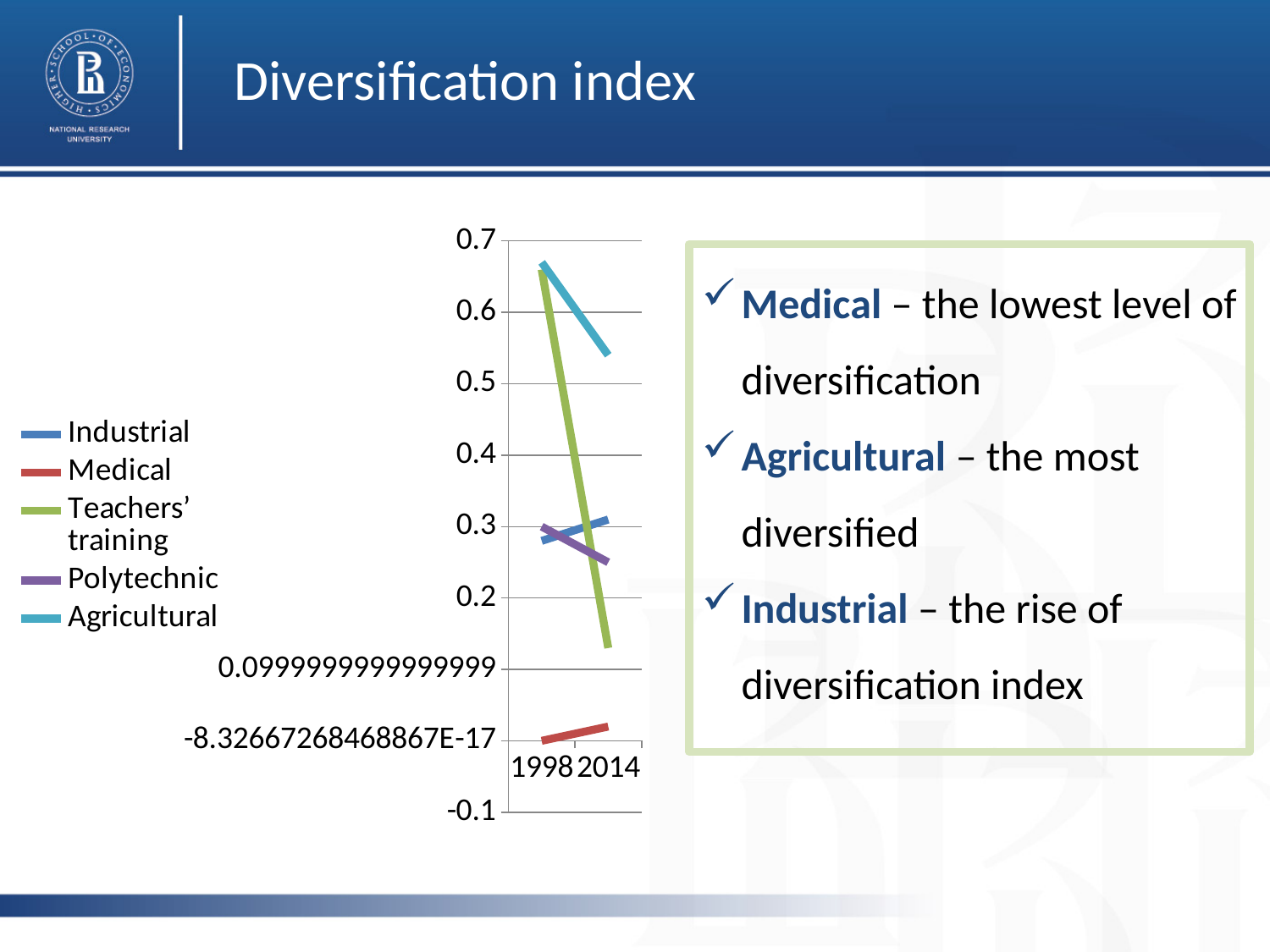
How many years are shown on the x axis? 2 Which series has the lowest value in 2014? Medical Is the value for Teachers' training in 2014 greater or less than 0.2? less Which series has the highest value in 2014? Agricultural How many series does the legend list? 5 What is the title of the slide containing the chart? Diversification index Does the Industrial line rise or fall from 1998 to 2014? rise Does the Teachers' training line rise or fall from 1998 to 2014? fall What kind of chart is shown on the slide? line chart Is the value for Agricultural in 1998 greater or less than 0.6? greater Does the Agricultural line rise or fall from 1998 to 2014? fall Is the value for Agricultural in 2014 greater or less than 0.5? greater